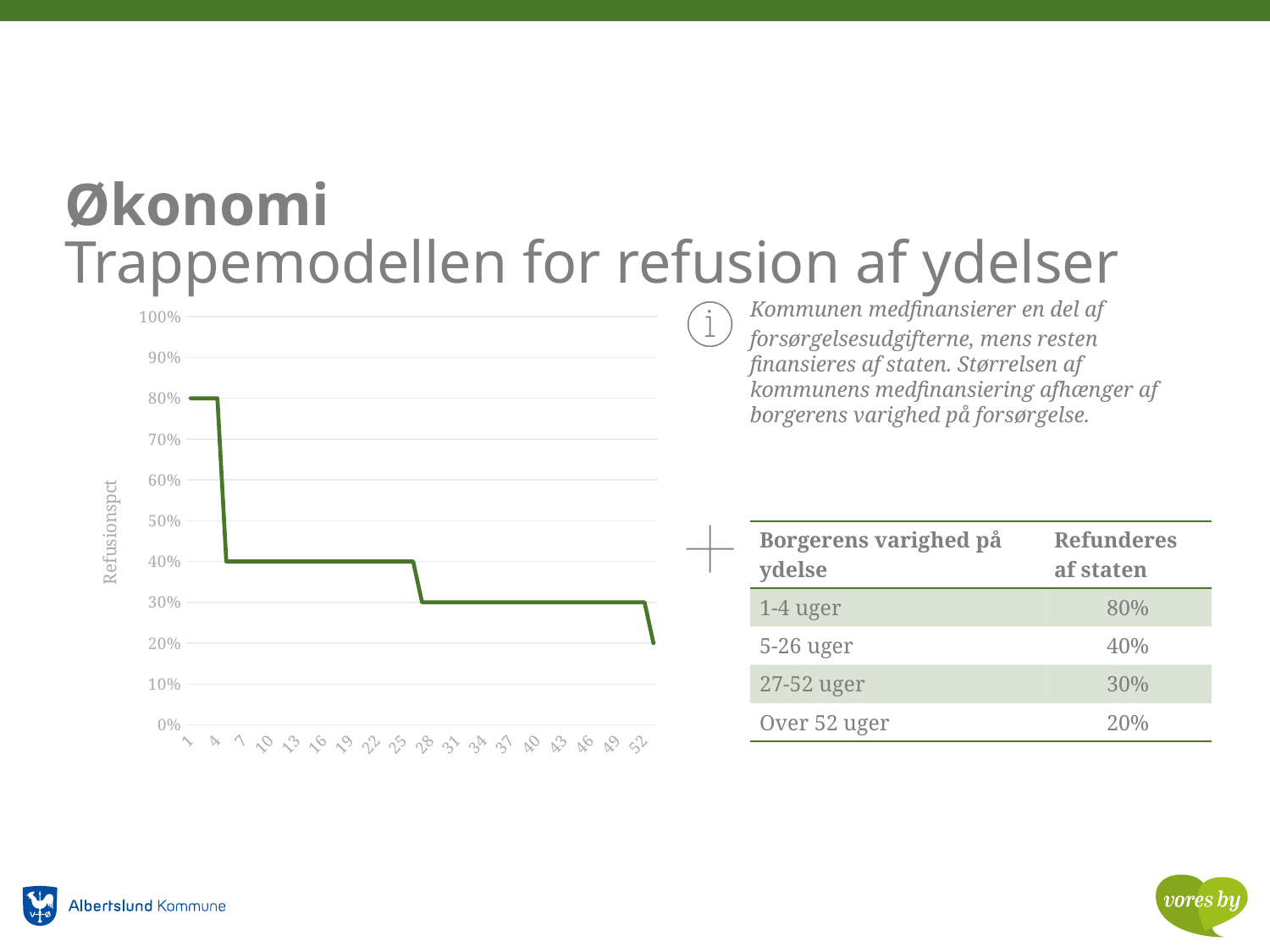
What is the refusion percentage at week 10 in the chart? 40% What is the label on the vertical axis of the chart? Refusionspct What is the refusion percentage at week 1 in the chart? 80% Do the values in the chart rise or fall as the week number increases along the x axis? fall What is the lowest refusion percentage plotted in the chart? 20% What is the refusion percentage at week 52 in the chart? 30% What kind of chart is shown on the slide? line chart Which week has the higher refusion percentage in the chart, week 4 or week 40? week 4 What is the highest refusion percentage plotted in the chart? 80% Is the refusion percentage at week 20 greater or less than 50%? less By how many percentage points does the refusion percentage drop between week 4 and week 7 in the chart? 40 percentage points What is the refusion percentage at week 31 in the chart? 30%